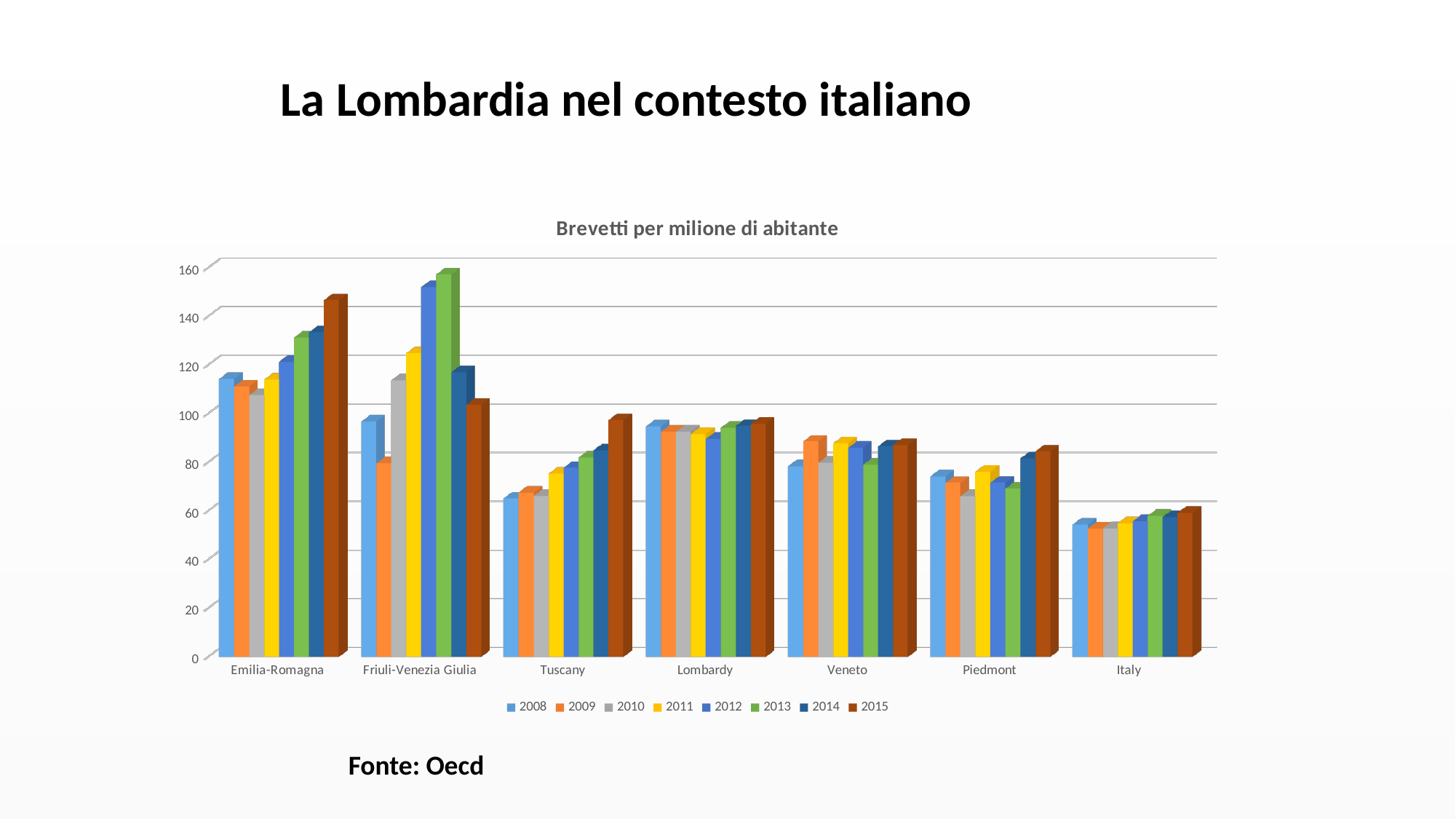
Is the value for Emilia-Romagna in 2015 greater or less than 140? greater Within Friuli-Venezia Giulia, which year has the lowest bar? 2009 Is the value for Tuscany in 2008 greater or less than 80? less Do the values for Emilia-Romagna rise or fall from 2010 to 2015? rise What is the title of the chart? Brevetti per milione di abitante Which category contains the tallest bar in the chart? Friuli-Venezia Giulia What kind of chart is shown on the slide? bar chart Is the value for Italy in 2015 greater or less than 80? less How many series (years) does the legend list? 8 Which is larger in 2015: the value for Emilia-Romagna or the value for Friuli-Venezia Giulia? Emilia-Romagna Which category has the lowest bars overall in the chart? Italy How many regions/categories are shown on the x axis of the chart? 7